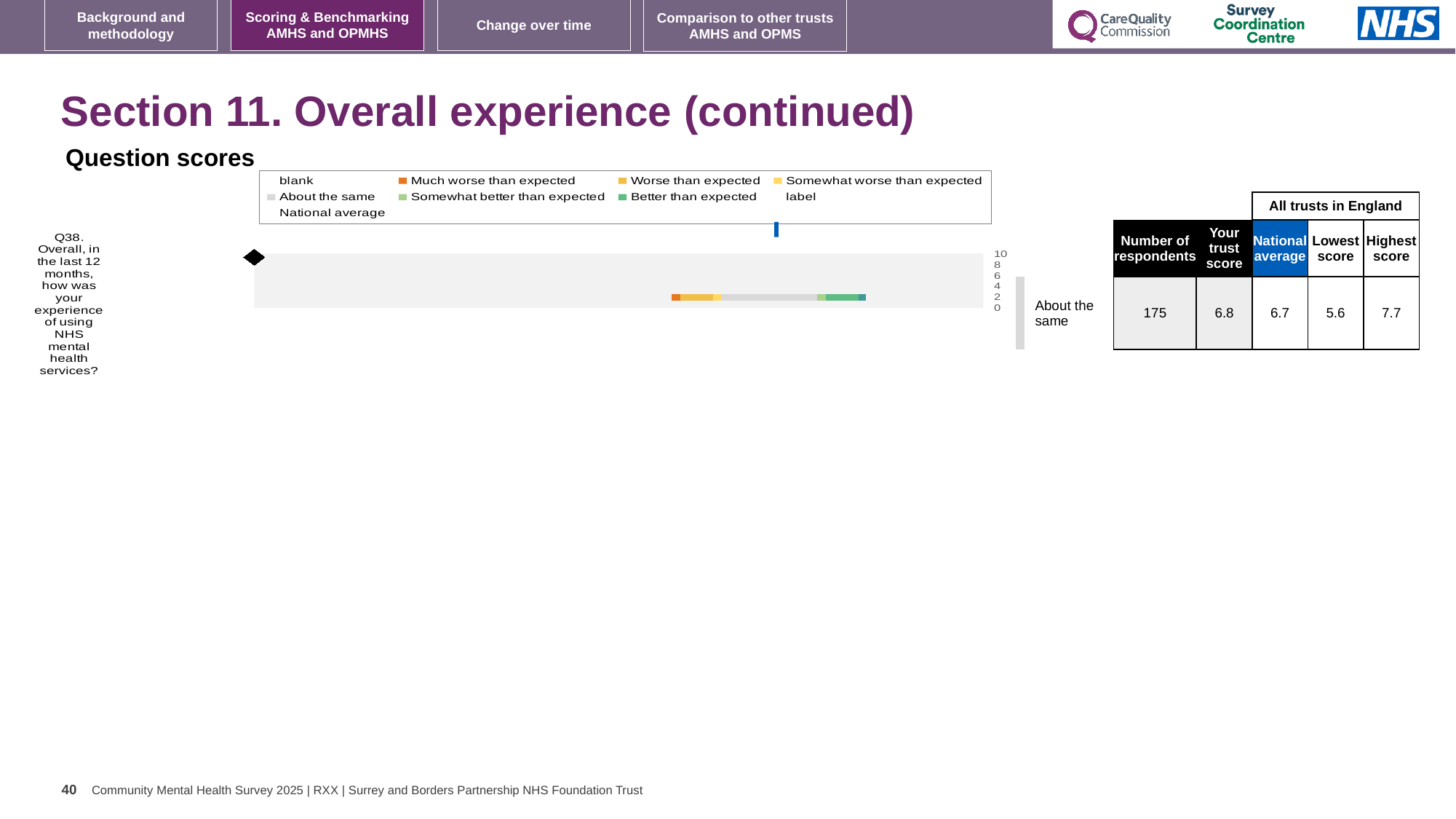
In the table next to the chart, which is larger for Q38: your trust score or the national average? Your trust score How many questions (categories) are plotted in the chart? 1 In the table next to the chart, what is the lowest score among all trusts in England for Q38? 5.6 What is the highest value shown on the chart's axis? 10 Which question number is plotted in the chart? Q38 In the table next to the chart, what is the difference between the highest score and the lowest score for Q38? 2.1 What benchmark label is shown to the right of the bar for Q38? About the same In the table next to the chart, what is the number of respondents for Q38? 175 In the table next to the chart, what is the highest score among all trusts in England for Q38? 7.7 What kind of chart is shown under 'Question scores'? bar chart In the table next to the chart, what is the national average for Q38? 6.7 In the table next to the chart, what is 'Your trust score' for Q38? 6.8